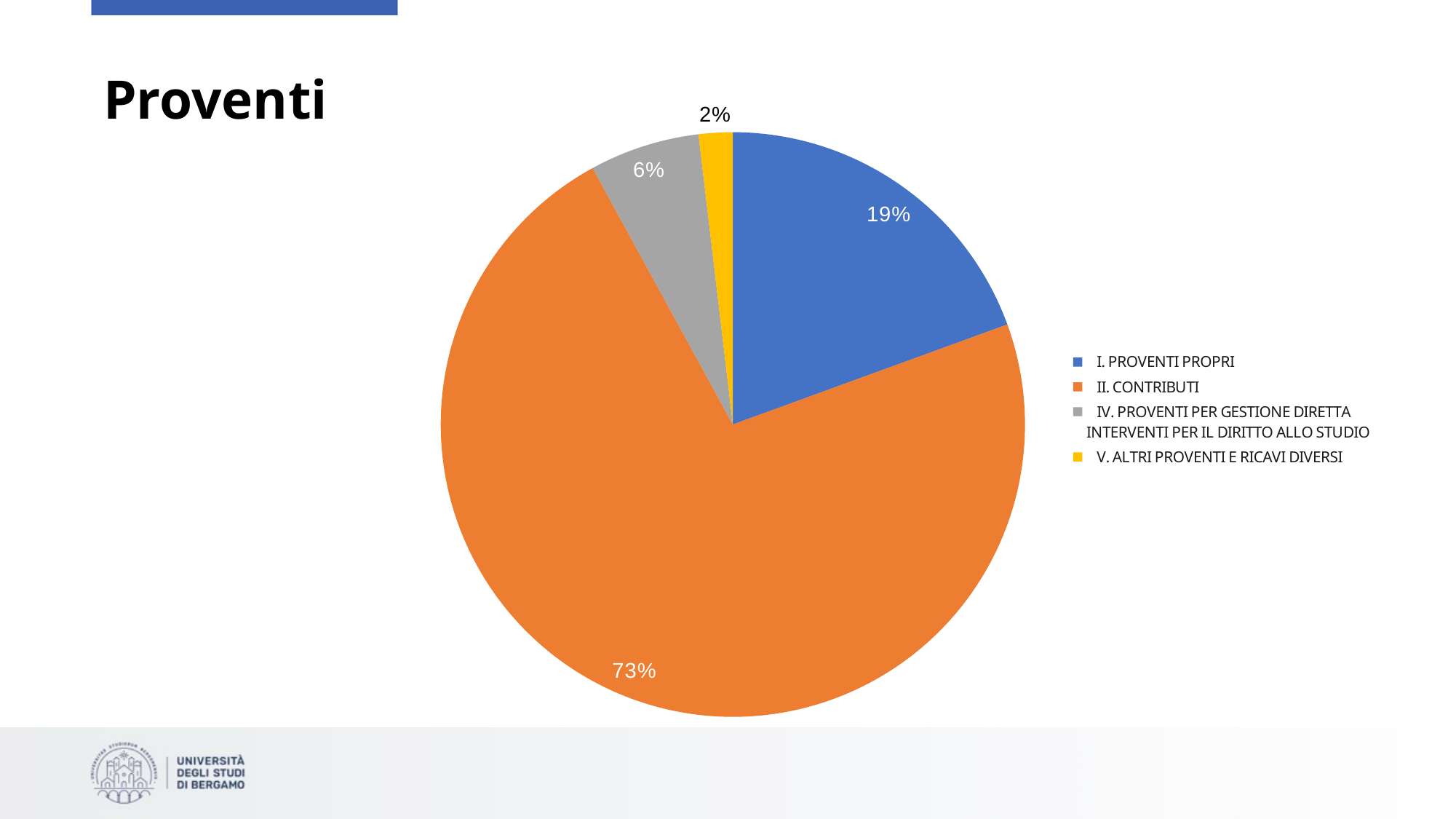
What colour is the slice for II. CONTRIBUTI? Orange What is the title of the slide containing the pie chart? Proventi What share of the pie does II. CONTRIBUTI represent? 73% How many categories are shown in the pie chart? 4 What share of the pie does IV. PROVENTI PER GESTIONE DIRETTA INTERVENTI PER IL DIRITTO ALLO STUDIO represent? 6% What share of the pie does I. PROVENTI PROPRI represent? 19% What kind of chart is shown on the slide? Pie chart Which is larger, the slice for I. PROVENTI PROPRI or the slice for IV. PROVENTI PER GESTIONE DIRETTA INTERVENTI PER IL DIRITTO ALLO STUDIO? I. PROVENTI PROPRI Which category has the largest slice of the pie? II. CONTRIBUTI Which category has the smallest slice of the pie? V. ALTRI PROVENTI E RICAVI DIVERSI What is the difference in percentage points between II. CONTRIBUTI and I. PROVENTI PROPRI? 54